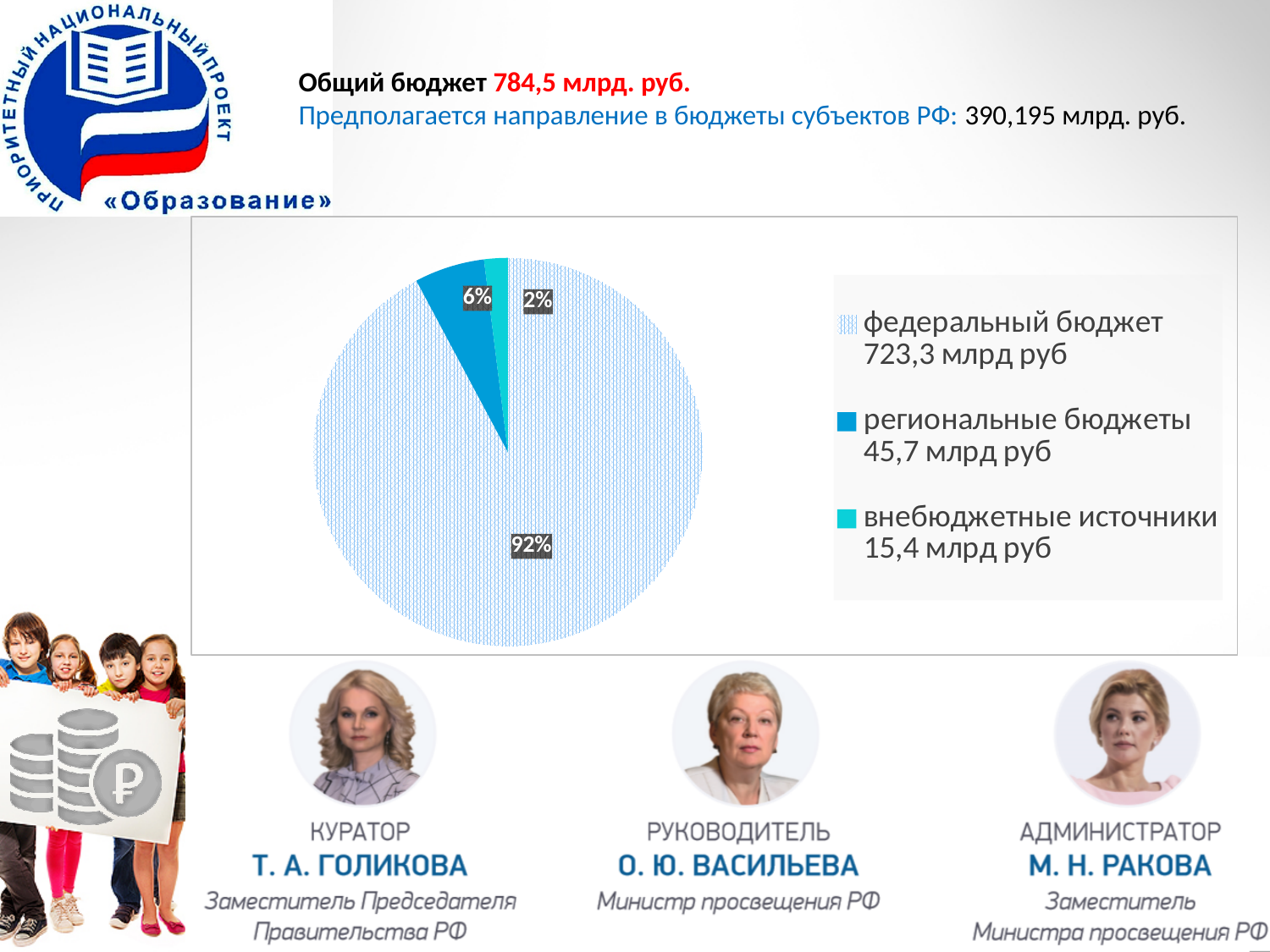
How many entries does the legend of the pie chart list? 3 How many slices does the pie chart have? 3 What value does the legend give for внебюджетные источники? 15,4 млрд руб What kind of chart is shown on the slide? pie chart Which slice of the pie chart is the largest? федеральный бюджет What value does the legend give for федеральный бюджет? 723,3 млрд руб What value does the legend give for региональные бюджеты? 45,7 млрд руб What share of the pie do внебюджетные источники take? 2% What share of the pie does федеральный бюджет take? 92% What share of the pie do региональные бюджеты take? 6% Which slice of the pie chart is the smallest? внебюджетные источники By how many млрд руб do региональные бюджеты exceed внебюджетные источники? 30,3 млрд руб